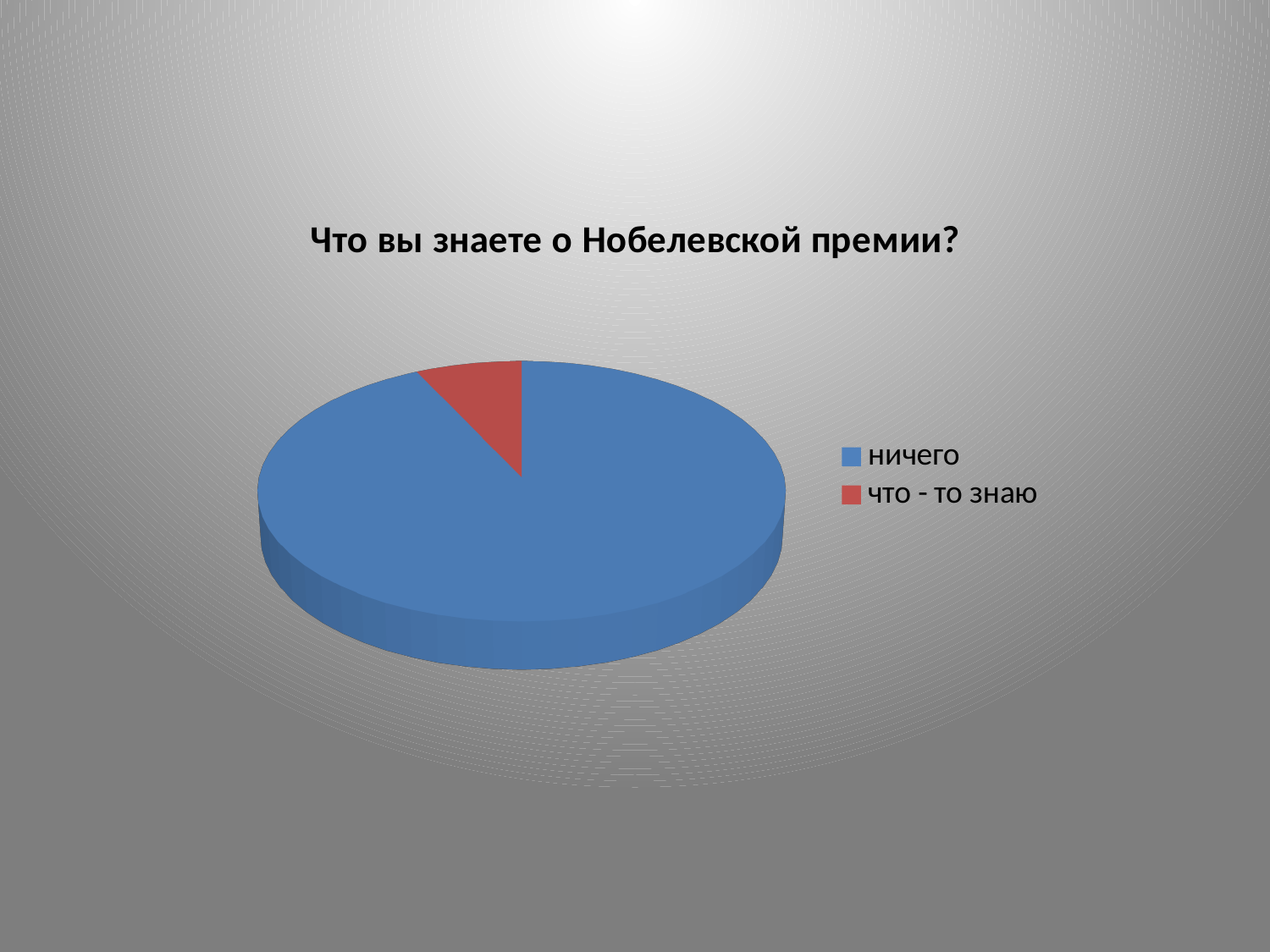
Which category has the largest slice of the pie? ничего Is the share of the "что - то знаю" slice greater or less than 25%? less What is the title of the chart? Что вы знаете о Нобелевской премии? Is the share of the "ничего" slice greater or less than 50%? greater Which category has the smallest slice of the pie? что - то знаю What kind of chart is shown on the slide? pie chart What colour is the slice for "что - то знаю"? red Which slice is larger, "ничего" or "что - то знаю"? ничего How many categories does the legend list? 2